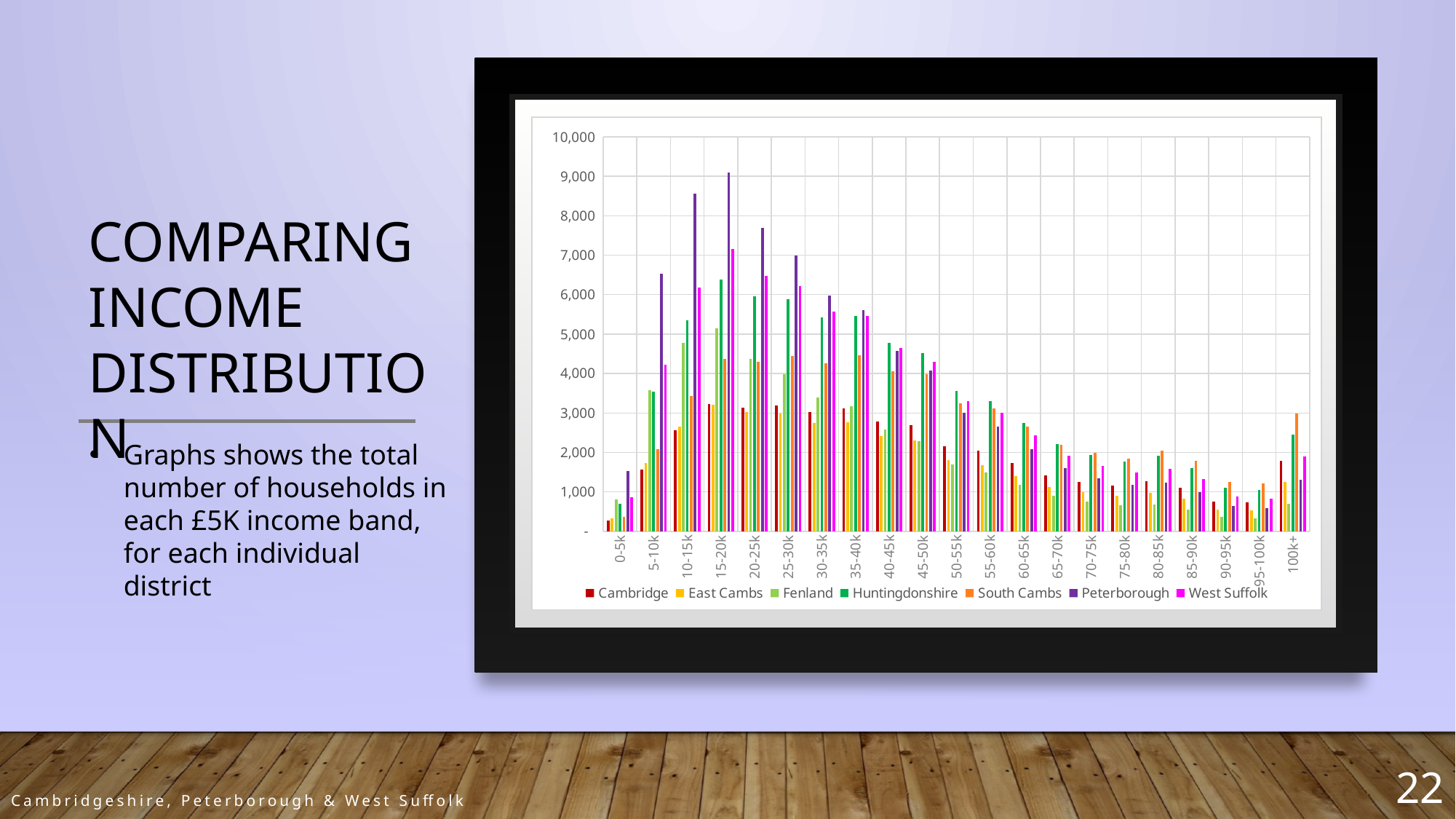
How many income bands are shown along the x axis? 21 How many series does the legend list? 7 Is the value for Fenland in the 100k+ band greater or less than 1,000? less Which district has the tallest bar anywhere on the chart? Peterborough What kind of chart is shown on the slide? bar chart Is the value for Cambridge in the 0-5k band greater or less than 1,000? less In which income band does Peterborough reach its highest value? 15-20k Do the Peterborough values rise or fall from the 15-20k band to the 95-100k band? fall Is the value for Huntingdonshire in the 15-20k band greater or less than 6,000? greater Which colour represents Peterborough in the legend? purple In the 100k+ band, which is larger: South Cambs or Cambridge? South Cambs